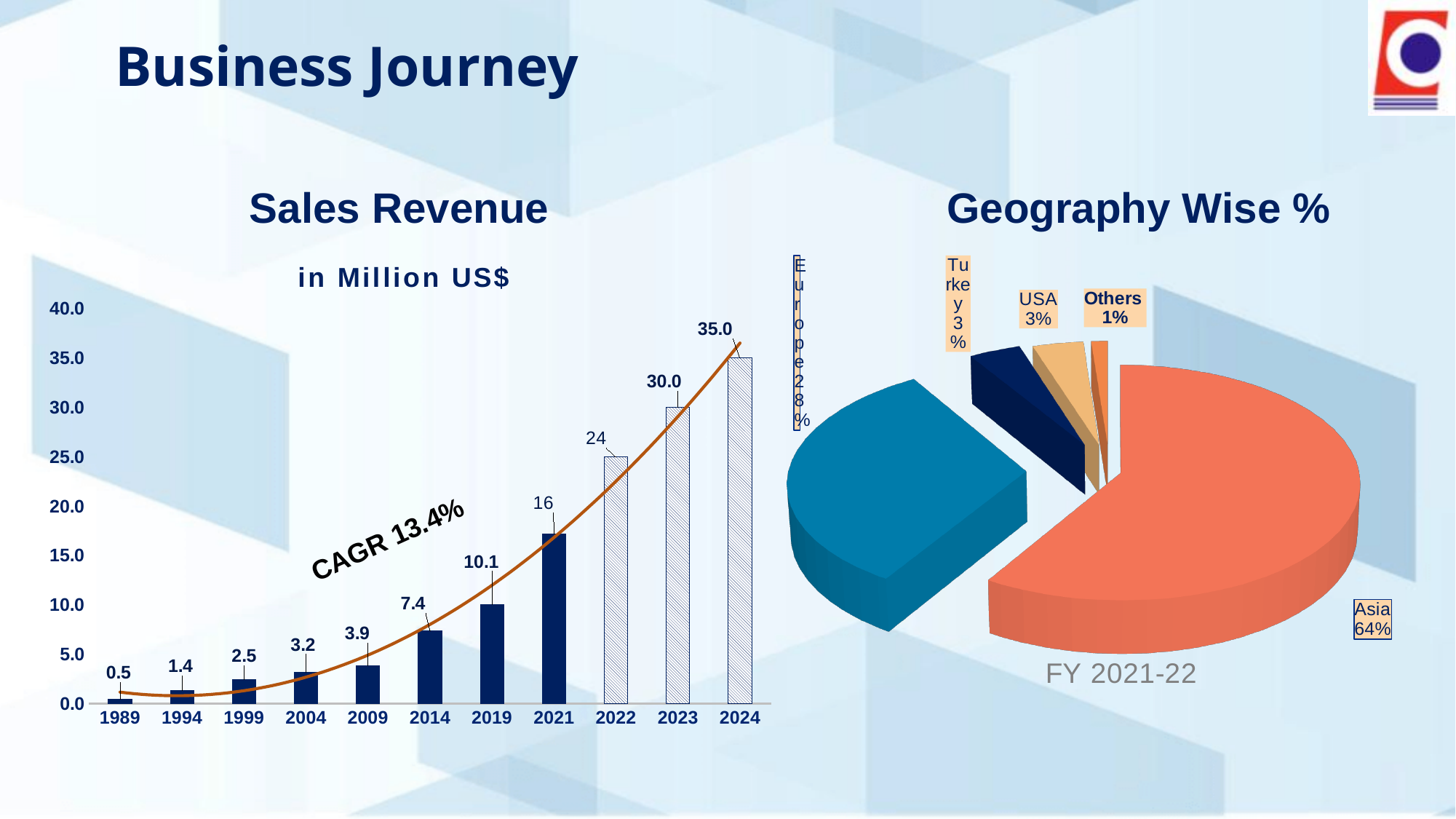
In the Sales Revenue chart, do the values rise or fall from 1989 to 2024? rise In the Sales Revenue chart, what is the value for 2019? 10.1 In the Sales Revenue chart, what is the value for 2024? 35.0 In the Geography Wise % chart, what share does Asia have? 64% In the Sales Revenue chart, which is larger, the value for 2014 or the value for 2009? 2014 How many slices does the Geography Wise % pie chart have? 5 What kind of chart is the Sales Revenue chart? bar chart In the Sales Revenue chart, which year has the highest value? 2024 In the Sales Revenue chart, which year has the lowest value? 1989 In the Sales Revenue chart, what is the value for 1989? 0.5 How many years are shown on the x axis of the Sales Revenue chart? 11 In the Sales Revenue chart, what is the difference between the values for 2023 and 2022? 6